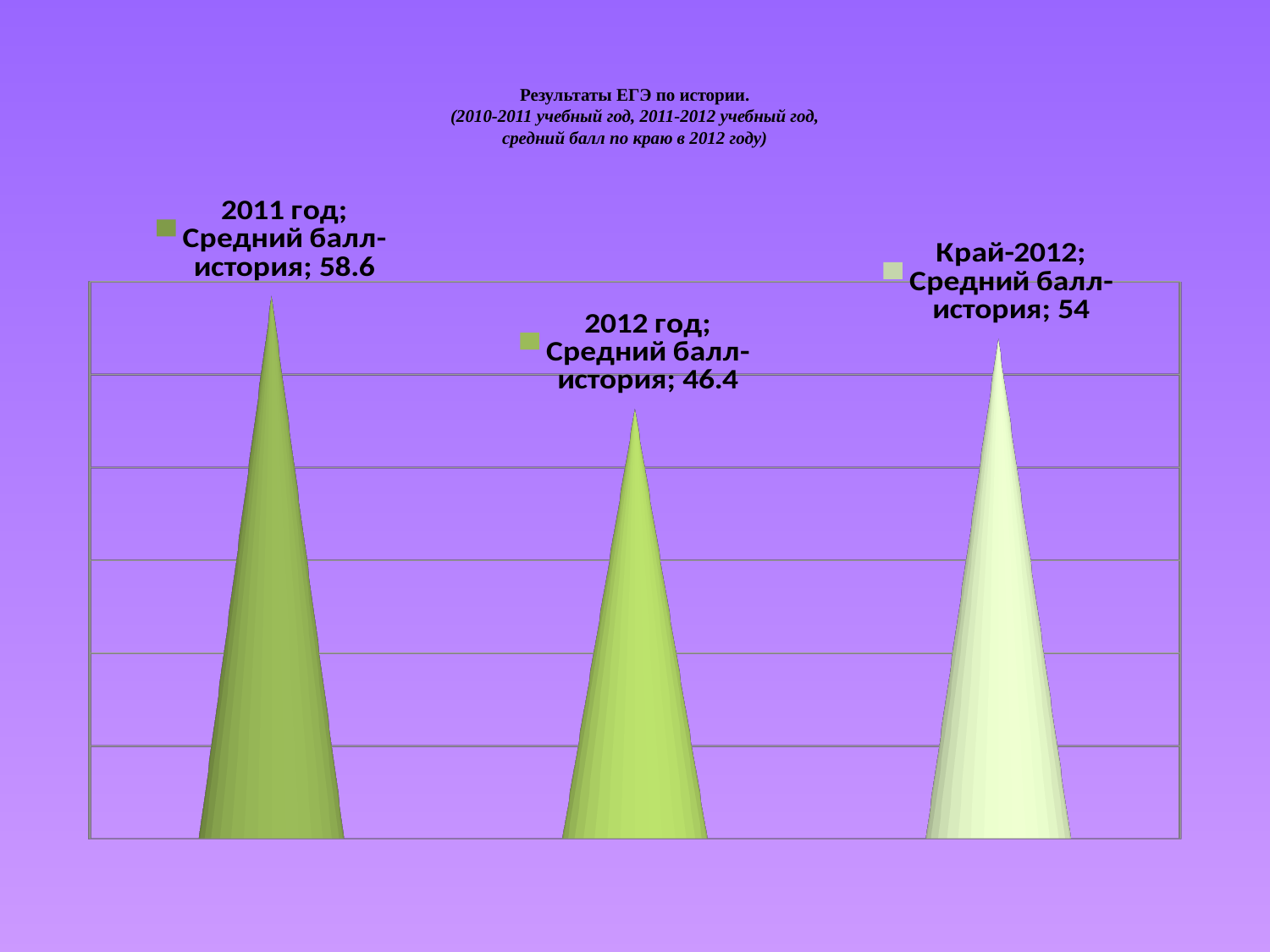
What is the difference between the average history score for 2011 год and 2012 год? 12.2 What is the average history score (Средний балл-история) for 2012 год? 46.4 Which category has the lowest average history score? 2012 год What is the difference between the average history score for Край-2012 and 2012 год? 7.6 What is the average history score (Средний балл-история) for 2011 год? 58.6 What is the title of the chart on the slide? Результаты ЕГЭ по истории. How many categories are plotted on the chart? 3 What is the average history score (Средний балл-история) for Край-2012? 54 What kind of chart is shown on the slide? Bar chart Does the average history score rise or fall from 2011 год to 2012 год? Fall Which category has the highest average history score? 2011 год Which is larger: the average history score for 2012 год or for Край-2012? Край-2012